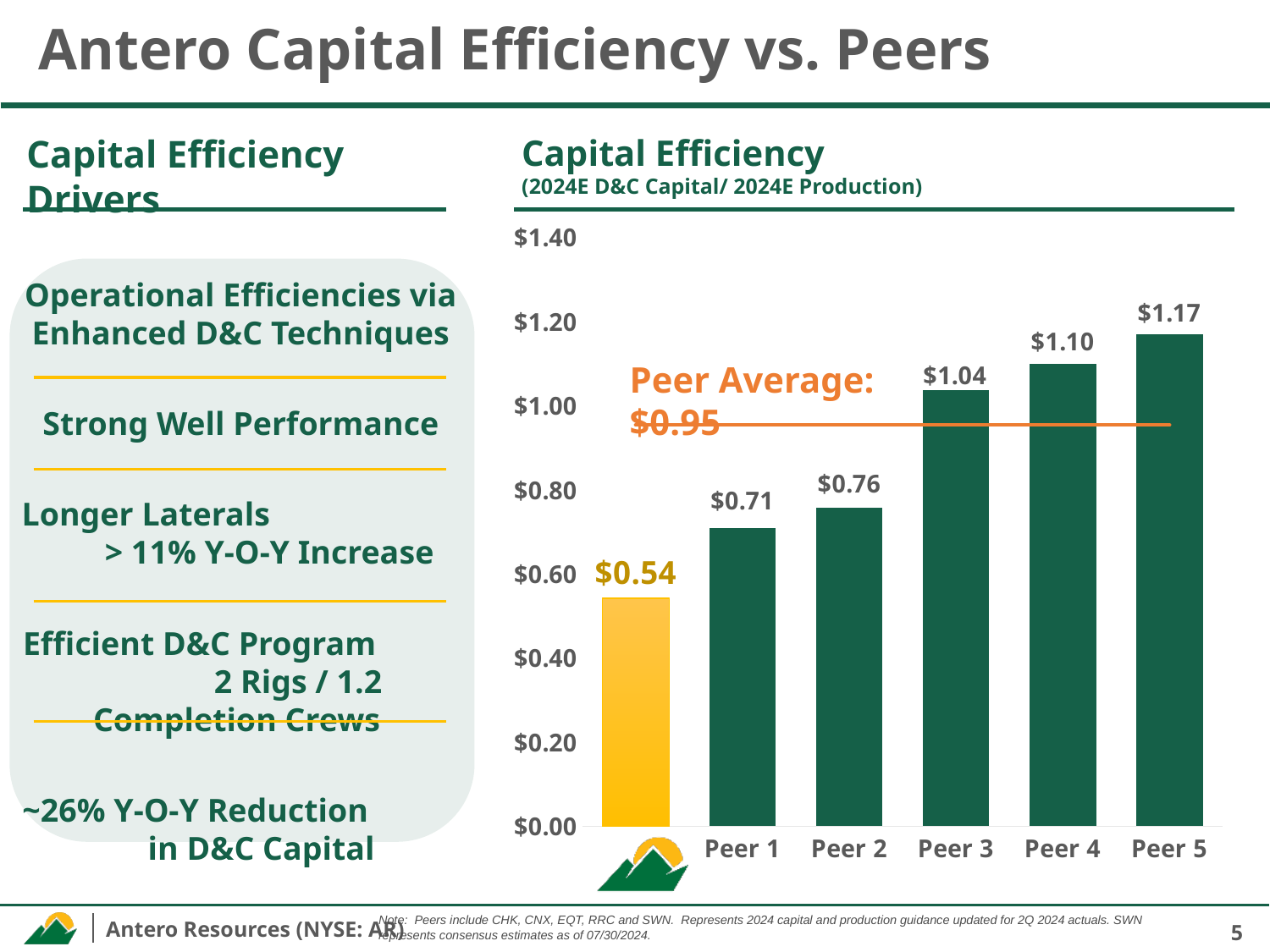
Which is larger in the Capital Efficiency chart, Peer 2 or Peer 3? Peer 3 How many bars are plotted in the Capital Efficiency chart? 6 Which bar has the lowest value in the Capital Efficiency chart? The yellow bar (Antero), $0.54 What is the difference between Peer 2 and the yellow Antero bar in the Capital Efficiency chart? $0.22 What is the value for Peer 3 in the Capital Efficiency chart? $1.04 What is the value shown for the yellow bar (Antero) in the Capital Efficiency chart? $0.54 Is the value for Peer 1 in the Capital Efficiency chart greater or less than $0.80? less What Peer Average value is marked by the orange line in the Capital Efficiency chart? $0.95 What is the value for Peer 5 in the Capital Efficiency chart? $1.17 What is the difference between Peer 4 and Peer 1 in the Capital Efficiency chart? $0.39 Which category has the highest value in the Capital Efficiency chart? Peer 5 What type of chart is the Capital Efficiency chart? Bar chart